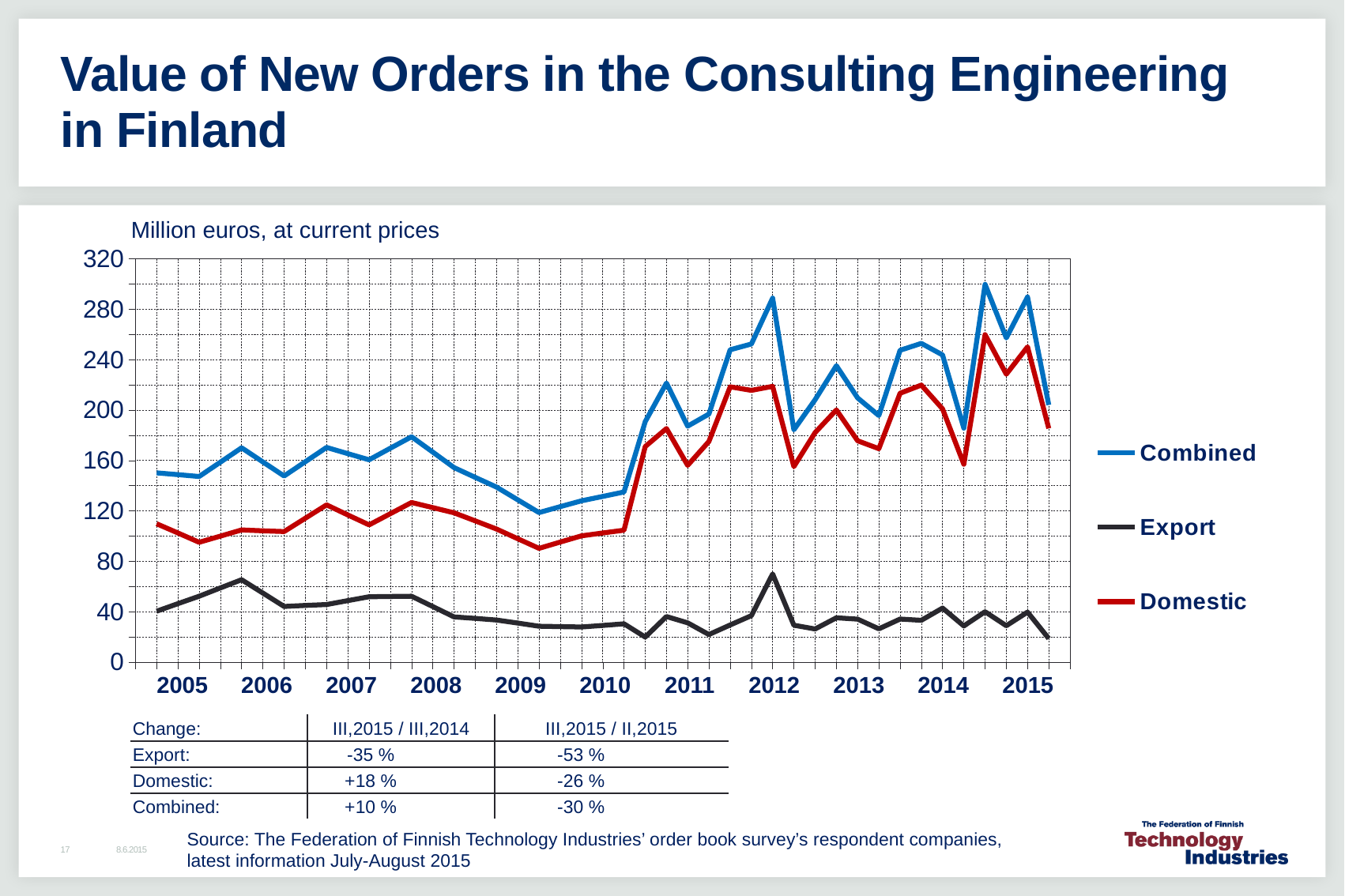
Which series has the lowest values throughout the chart? Export Which series has the highest values throughout the chart? Combined What unit is the chart measured in, according to the label above it? Million euros, at current prices Is the value of the Domestic series in 2009 greater or less than 120? less Is the peak value of the Export series in 2012 greater or less than 40? greater In 2012, which is larger, the Domestic value or the Export value? Domestic Does the Combined series overall rise or fall from 2005 to 2015? rise How many series does the legend list? 3 How many years are labelled on the x axis? 11 What colour is the Domestic line in the legend? red Is the peak value of the Combined series in 2014 greater or less than 280? greater What kind of chart is shown on the slide? line chart